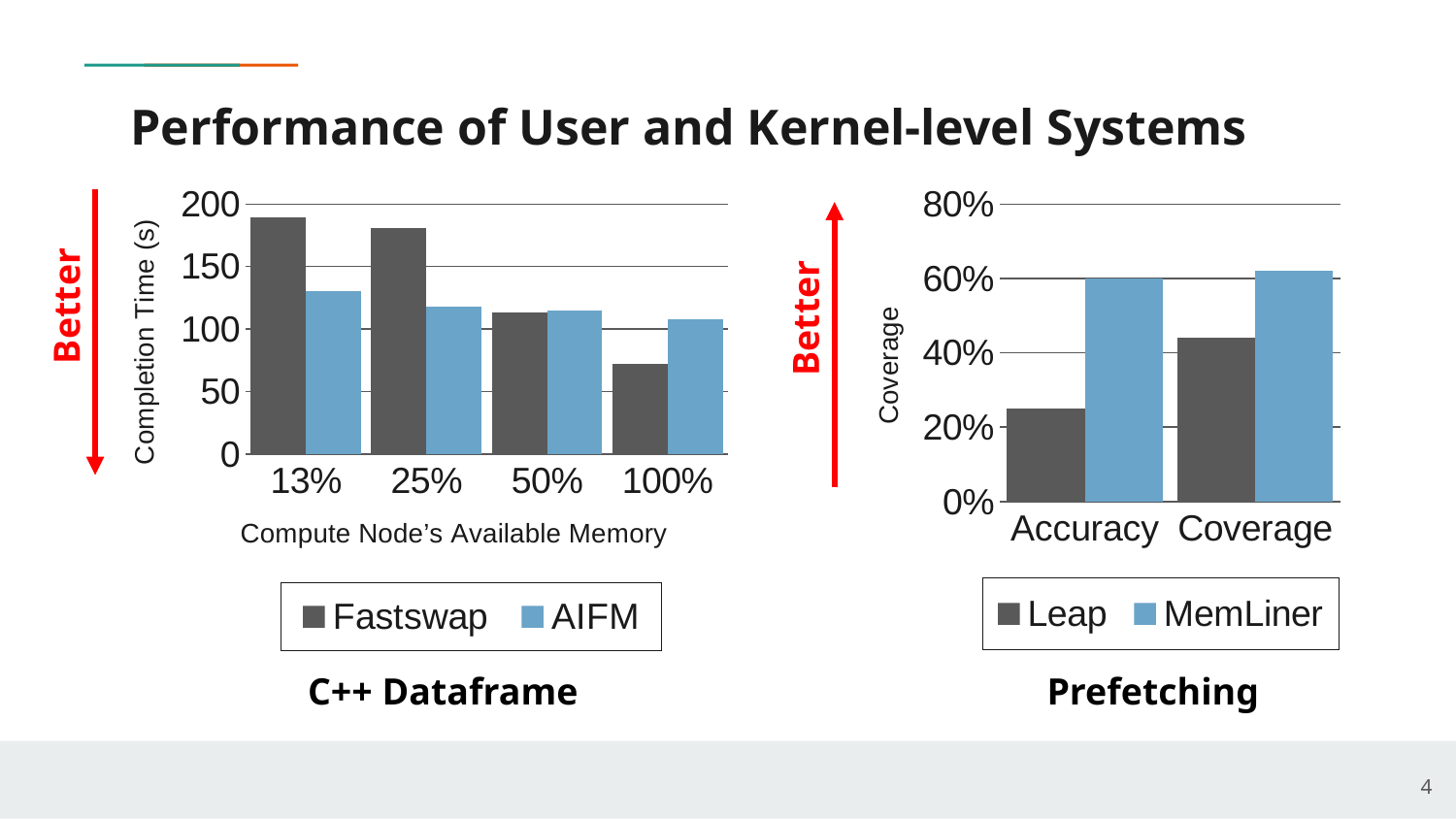
In the Prefetching chart, is the Leap value for Accuracy greater or less than 40%? less In the C++ Dataframe chart, does the Fastswap completion time rise or fall as available memory increases from 13% to 100%? fall In the Prefetching chart, which system has the higher Accuracy, Leap or MemLiner? MemLiner In the C++ Dataframe chart, how many series does the legend list? 2 In the C++ Dataframe chart, is the Fastswap completion time at 13% greater or less than 150? greater In the C++ Dataframe chart, is the Fastswap completion time at 100% greater or less than 100? less In the C++ Dataframe chart, at 13% available memory, which system has the larger completion time, Fastswap or AIFM? Fastswap In the C++ Dataframe chart, at which available memory level is the Fastswap completion time lowest? 100% In the C++ Dataframe chart, what kind of chart is shown? bar chart In the C++ Dataframe chart, at which available memory level is the Fastswap completion time highest? 13% In the C++ Dataframe chart, how many memory categories are shown on the x axis? 4 In the Prefetching chart, how many series does the legend list? 2